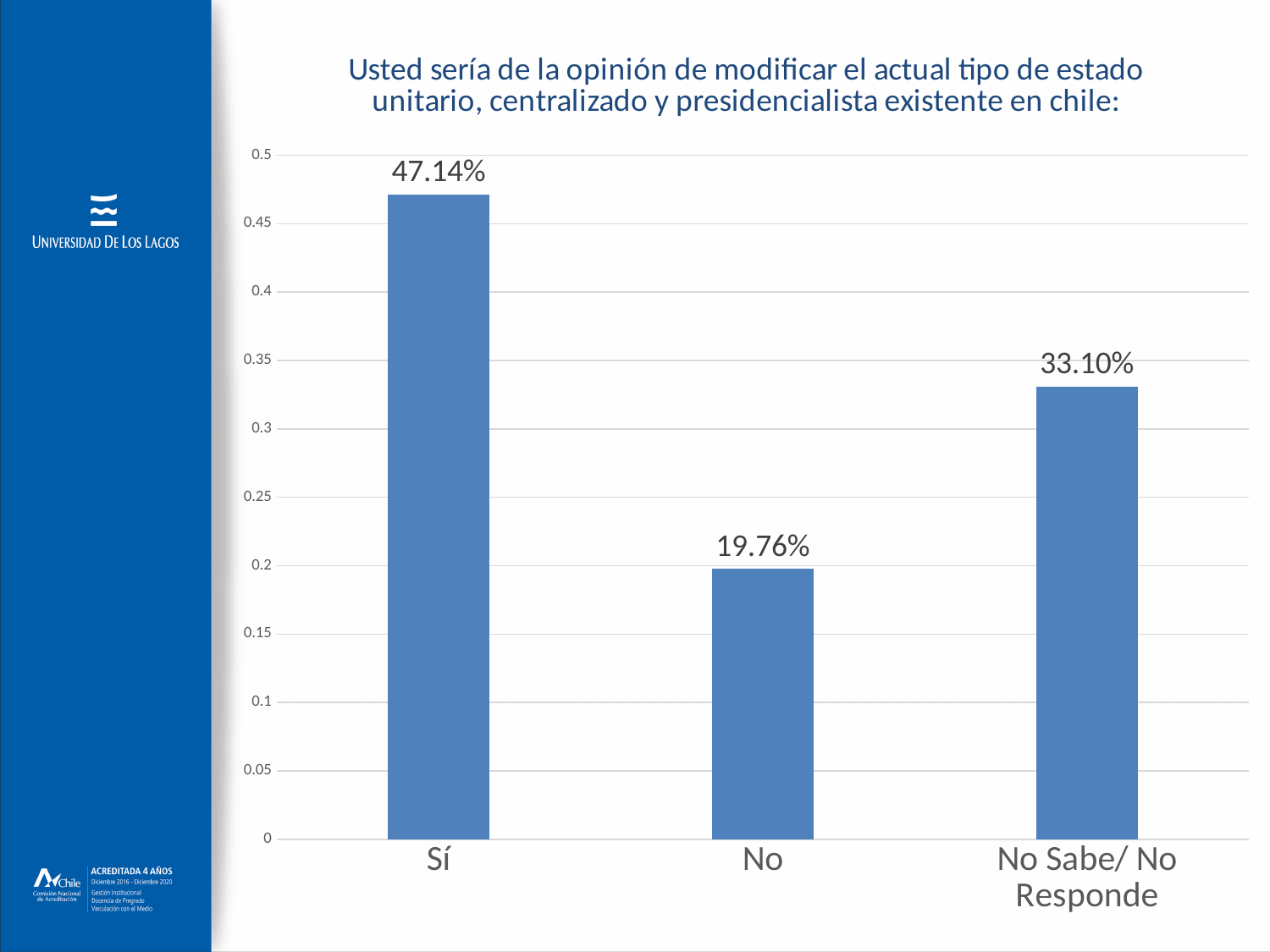
What is the value for "No Sabe/ No Responde"? 33.10% Which category has the lowest value? No Which category has the highest value? Sí What is the value for "Sí"? 47.14% What is the title of the chart? Usted sería de la opinión de modificar el actual tipo de estado unitario, centralizado y presidencialista existente en chile: Is the value for "Sí" greater or less than 0.45? greater What kind of chart is shown on the slide? Bar chart Which is larger, the value for "No" or the value for "No Sabe/ No Responde"? No Sabe/ No Responde What is the difference between the values for "Sí" and "No"? 27.38% How many categories are shown on the x axis? 3 What is the difference between the values for "No Sabe/ No Responde" and "No"? 13.34% What is the value for "No"? 19.76%